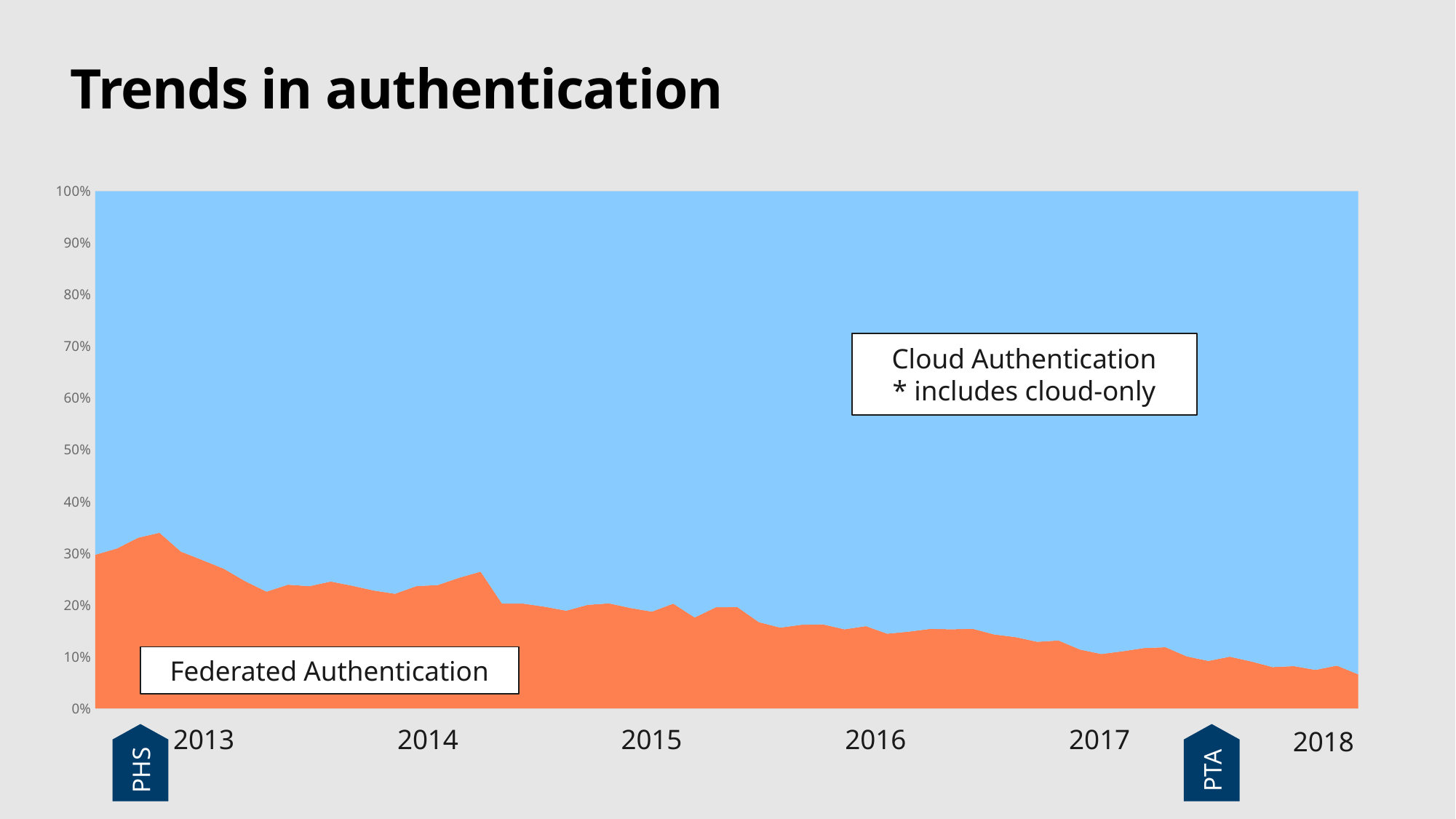
Is the value for Federated Authentication at the start of the chart greater or less than 20%? greater Is the value for Federated Authentication at 2016 greater or less than 20%? less Is the value for Federated Authentication at the end of the chart (2018) greater or less than 10%? less What is the title of the slide? Trends in authentication Does the share of Cloud Authentication rise or fall from 2013 to 2018? rise What kind of chart is shown on the slide? area chart How many series are labelled on the chart? 2 Which series has the larger share at 2017, Cloud Authentication or Federated Authentication? Cloud Authentication Does the share of Federated Authentication rise or fall from 2013 to 2018? fall How many year labels are shown on the x axis? 6 What colour is the Federated Authentication area? orange